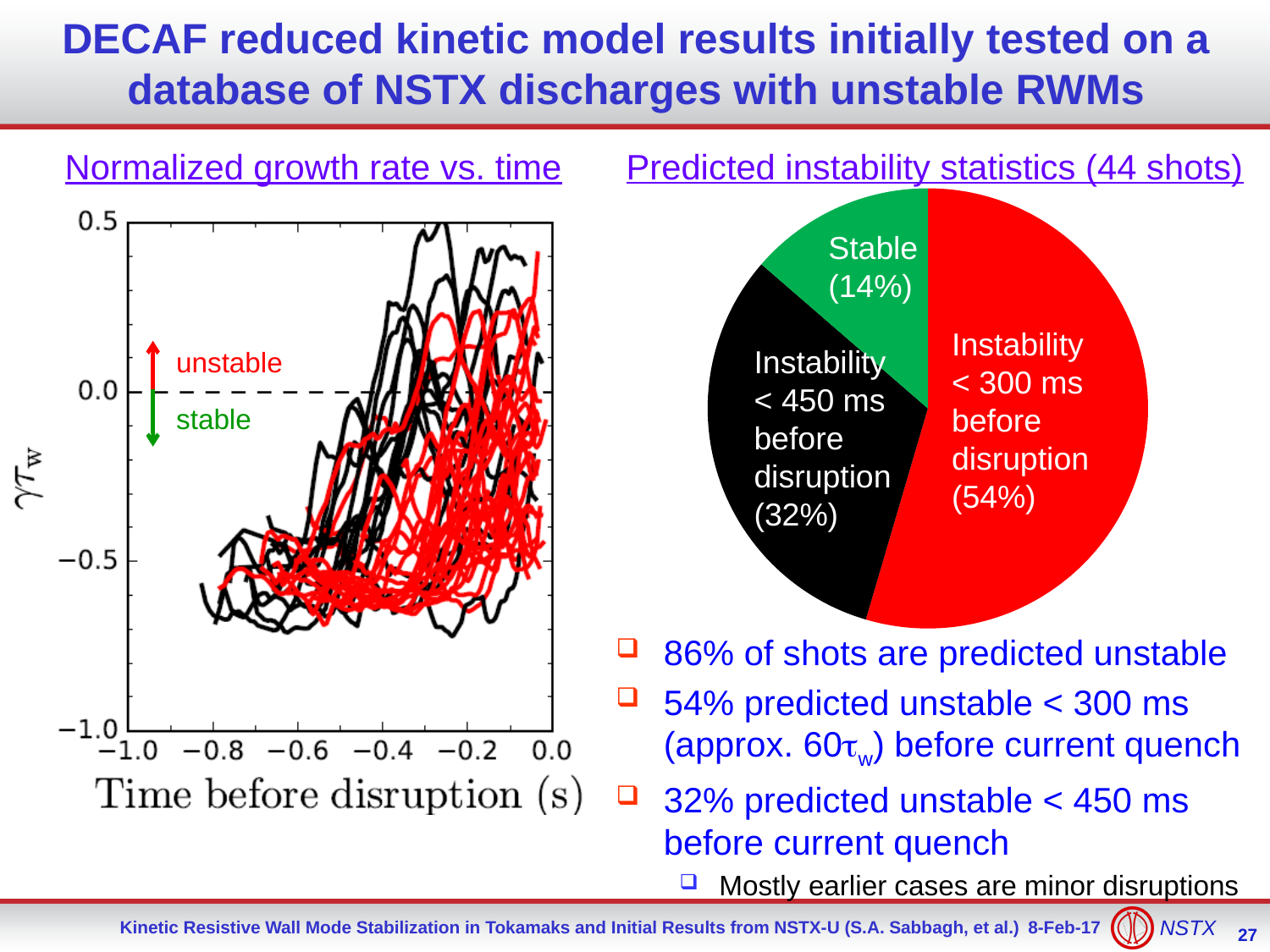
What kind of chart is the one titled 'Predicted instability statistics (44 shots)'? Pie chart In the pie chart titled 'Predicted instability statistics (44 shots)', which slice is the smallest? Stable In the pie chart titled 'Predicted instability statistics (44 shots)', what colour is the Stable slice? Green In the pie chart titled 'Predicted instability statistics (44 shots)', which slice is the largest? Instability < 300 ms before disruption In the chart titled 'Normalized growth rate vs. time', do the plotted growth rates generally rise or fall as time approaches 0.0 s before disruption? Rise In the pie chart titled 'Predicted instability statistics (44 shots)', which is larger: the Stable slice or the 'Instability < 450 ms before disruption' slice? Instability < 450 ms before disruption How many slices does the pie chart titled 'Predicted instability statistics (44 shots)' have? 3 In the pie chart titled 'Predicted instability statistics (44 shots)', what is the combined share of the two 'Instability' slices? 86% In the pie chart titled 'Predicted instability statistics (44 shots)', what is the difference in percentage points between the 'Instability < 300 ms before disruption' slice and the 'Instability < 450 ms before disruption' slice? 22 percentage points In the pie chart titled 'Predicted instability statistics (44 shots)', what share of shots is labelled Stable? 14% In the chart titled 'Normalized growth rate vs. time', what is the label of the x axis? Time before disruption (s) What kind of chart is the one titled 'Normalized growth rate vs. time' on the left of the slide? Line chart